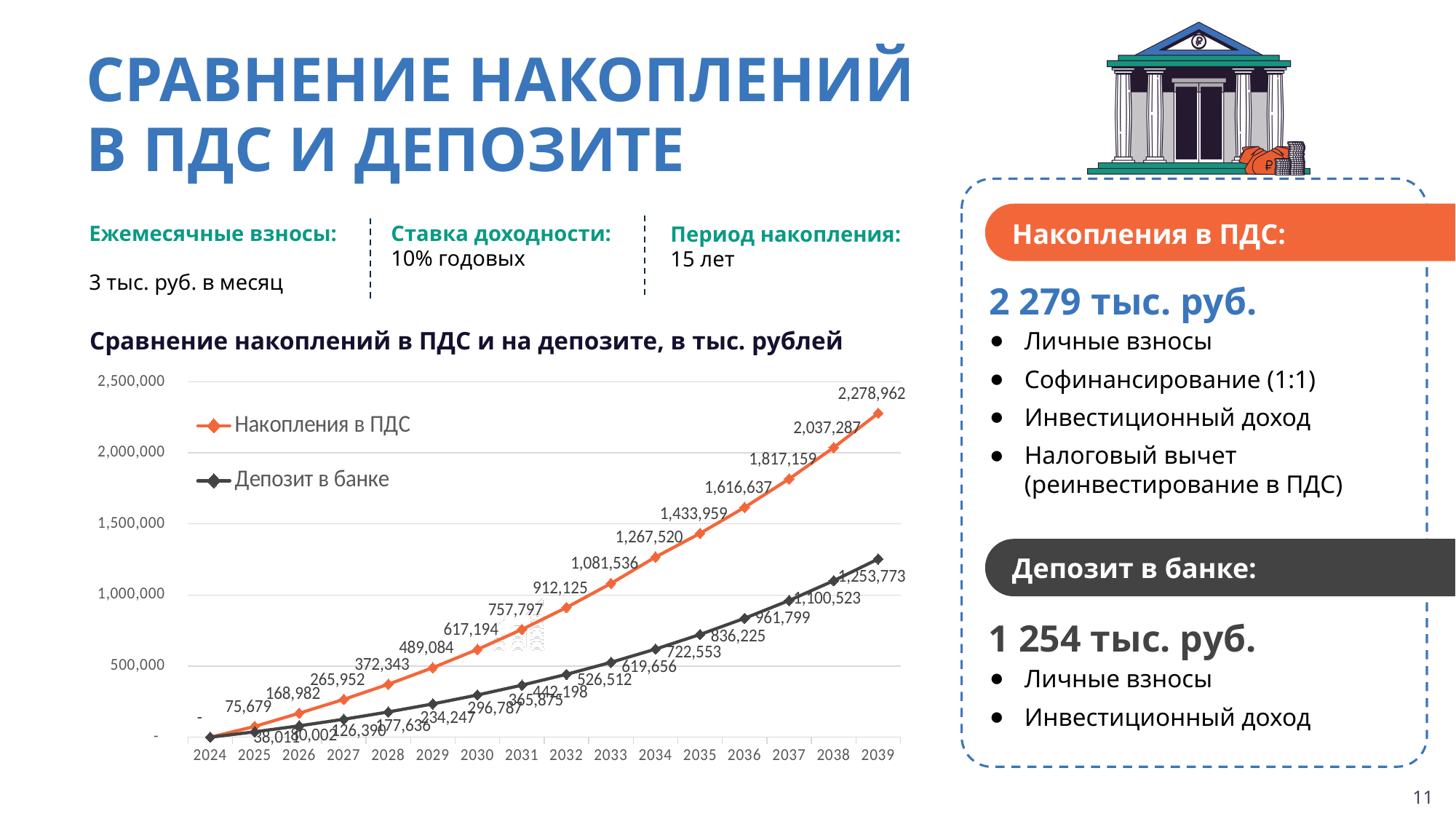
What is the value for Накопления в ПДС in 2039? 2,278,962 What is the difference between Накопления в ПДС and Депозит в банке in 2034? 647,864 Do the values for Накопления в ПДС rise or fall from 2024 to 2039? rise How many years are shown on the x axis of the chart? 16 What is the value for Депозит в банке in 2039? 1,253,773 What is the value for Депозит в банке in 2035? 722,553 What kind of chart is shown on the slide? line chart What is the difference between Накопления в ПДС and Депозит в банке in 2039? 1,025,189 In 2033, which series has the larger value: Накопления в ПДС or Депозит в банке? Накопления в ПДС How many series does the legend list? 2 What is the value for Накопления в ПДС in 2030? 617,194 Is the value for Депозит в банке in 2037 greater or less than 1,000,000? less